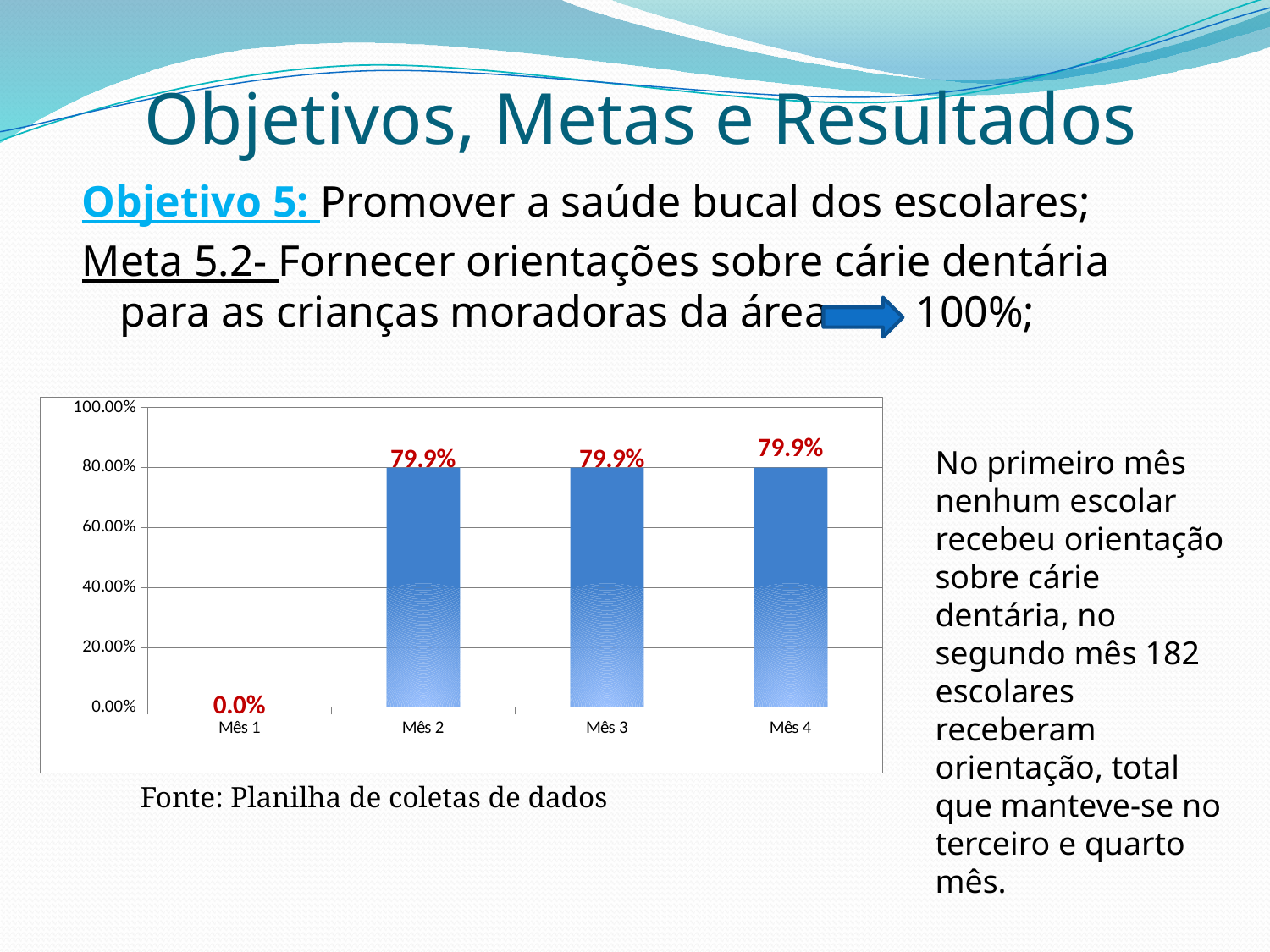
Is the value for Mês 3 greater or less than 60.00%? greater What kind of chart is shown on the slide? Bar chart What is the value for Mês 4? 79.9% What is the value for Mês 1? 0.0% Do the values change between Mês 2 and Mês 4? No, they stay at 79.9% What is the difference between the values for Mês 2 and Mês 1? 79.9% Which month has the lowest value? Mês 1 Does the value rise or fall from Mês 1 to Mês 2? rise Which is larger, the value for Mês 1 or the value for Mês 4? Mês 4 What source is cited below the chart? Planilha de coletas de dados How many months (categories) are shown on the x axis? 4 What is the value for Mês 2? 79.9%